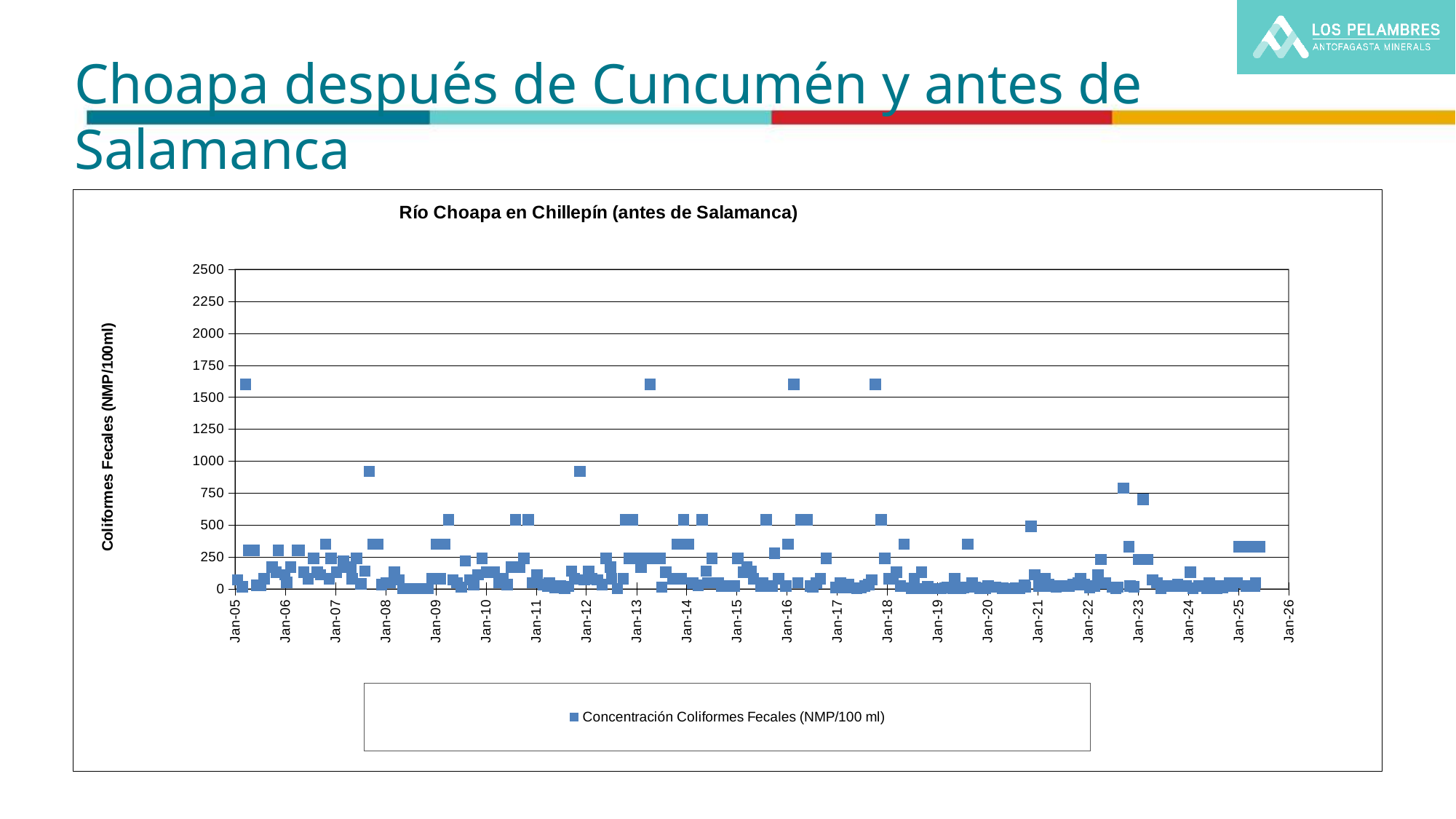
Is the highest plotted value on the chart greater or less than 1500? greater What is the label of the vertical axis? Coliformes Fecales (NMP/100ml) What is the legend entry for the plotted series? Concentración Coliformes Fecales (NMP/100 ml) Is the highest plotted value on the chart greater or less than 1750? less What is the maximum value shown on the vertical axis? 2500 Is the highest value plotted shortly before Jan-08 greater or less than 750? greater How many series does the chart legend list? 1 What kind of chart is shown on the slide? scatter chart